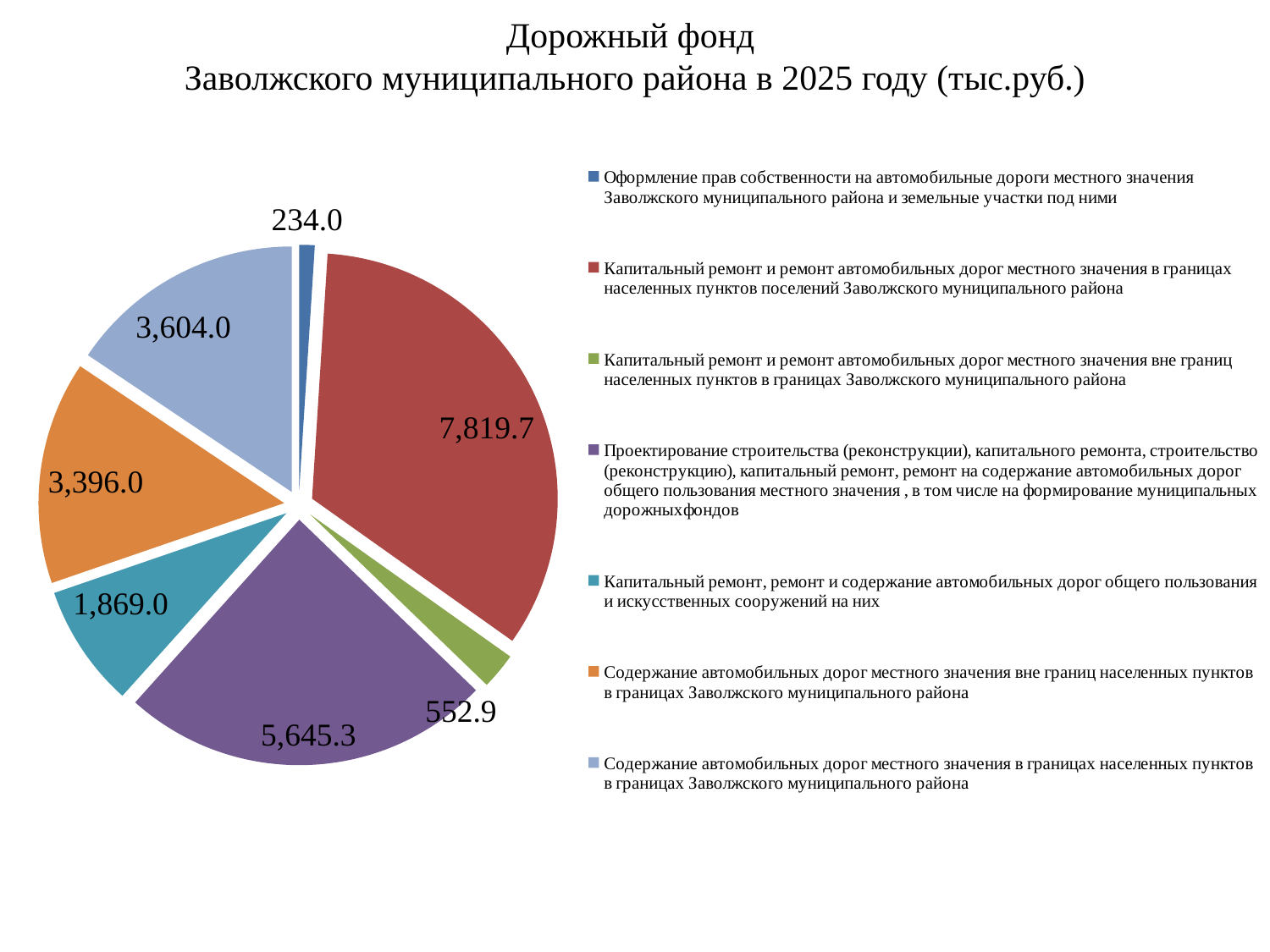
What is the value for "Капитальный ремонт, ремонт и содержание автомобильных дорог общего пользования и искусственных сооружений на них"? 1,869.0 How many entries does the legend list? 7 What is the value for "Оформление прав собственности на автомобильные дороги местного значения Заволжского муниципального района и земельные участки под ними"? 234.0 What is the title of the chart? Дорожный фонд Заволжского муниципального района в 2025 году (тыс.руб.) What kind of chart is shown on the slide? pie chart What is the value for "Содержание автомобильных дорог местного значения в границах населенных пунктов в границах Заволжского муниципального района"? 3,604.0 What is the value for "Капитальный ремонт и ремонт автомобильных дорог местного значения в границах населенных пунктов поселений Заволжского муниципального района"? 7,819.7 How many slices does the pie chart have? 7 Which category has the smallest slice of the pie? Оформление прав собственности на автомобильные дороги местного значения Заволжского муниципального района и земельные участки под ними What is the difference between the largest slice (7,819.7) and the slice labelled 5,645.3? 2,174.4 Which category has the largest slice of the pie? Капитальный ремонт и ремонт автомобильных дорог местного значения в границах населенных пунктов поселений Заволжского муниципального района Which is larger: the slice for "Содержание автомобильных дорог местного значения вне границ населенных пунктов" (3,396.0) or the slice for "Содержание автомобильных дорог местного значения в границах населенных пунктов" (3,604.0)? Содержание автомобильных дорог местного значения в границах населенных пунктов в границах Заволжского муниципального района